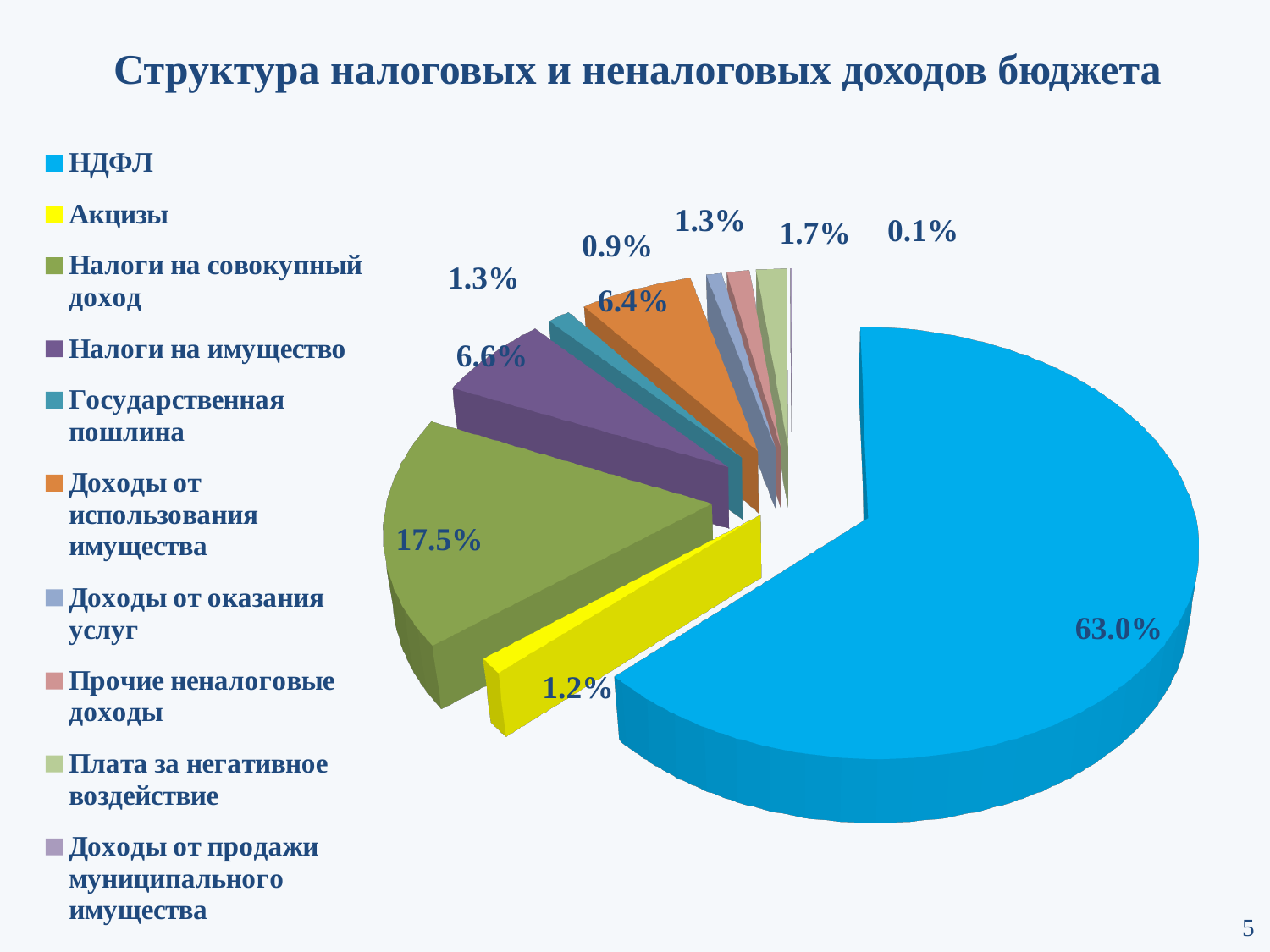
What share of the pie does НДФЛ have? 63.0% What share of the pie does Доходы от использования имущества have? 6.4% What share of the pie does Налоги на совокупный доход have? 17.5% What is the difference between the shares of НДФЛ and Налоги на совокупный доход? 45.5% How many categories does the legend list? 10 Which category has the smallest share of the pie? Доходы от продажи муниципального имущества What kind of chart is shown on the slide? Pie chart What share of the pie does Акцизы have? 1.2% What share of the pie does Доходы от продажи муниципального имущества have? 0.1% Which category has the largest share of the pie? НДФЛ What share of the pie does Налоги на имущество have? 6.6% What is the title of the chart? Структура налоговых и неналоговых доходов бюджета